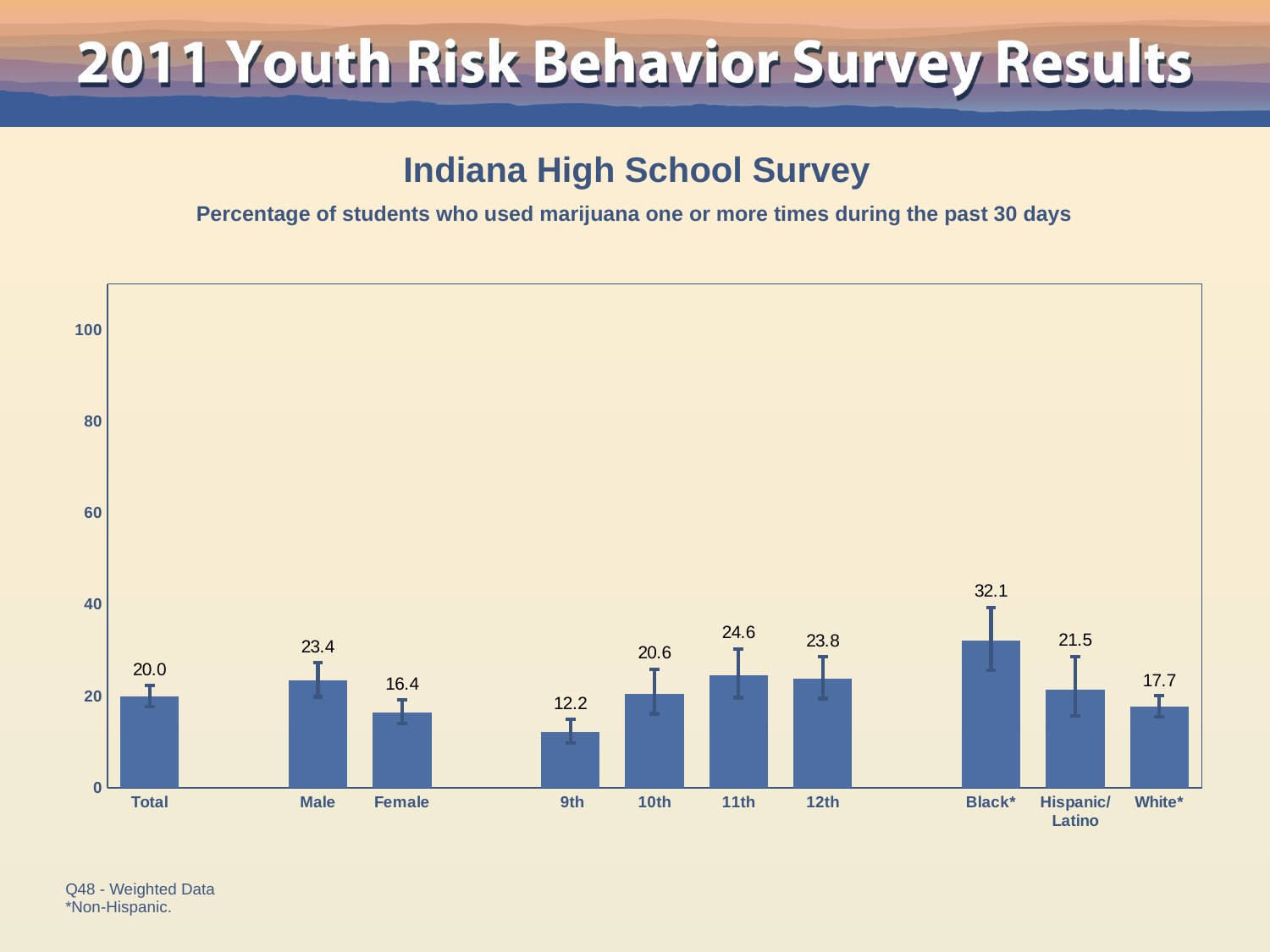
What is the value for Total? 20.0 Which is larger, the value for 11th or the value for 12th? 11th What is the value for 9th? 12.2 What is the difference between the values for Male and Female? 7.0 What kind of chart is this? bar chart What is the value for Female? 16.4 Which category has the highest value? Black* Is the value for White* greater or less than 20? less Which category has the lowest value? 9th What is the value for Hispanic/Latino? 21.5 How many categories are shown on the x axis? 10 What is the subtitle describing what the chart measures? Percentage of students who used marijuana one or more times during the past 30 days